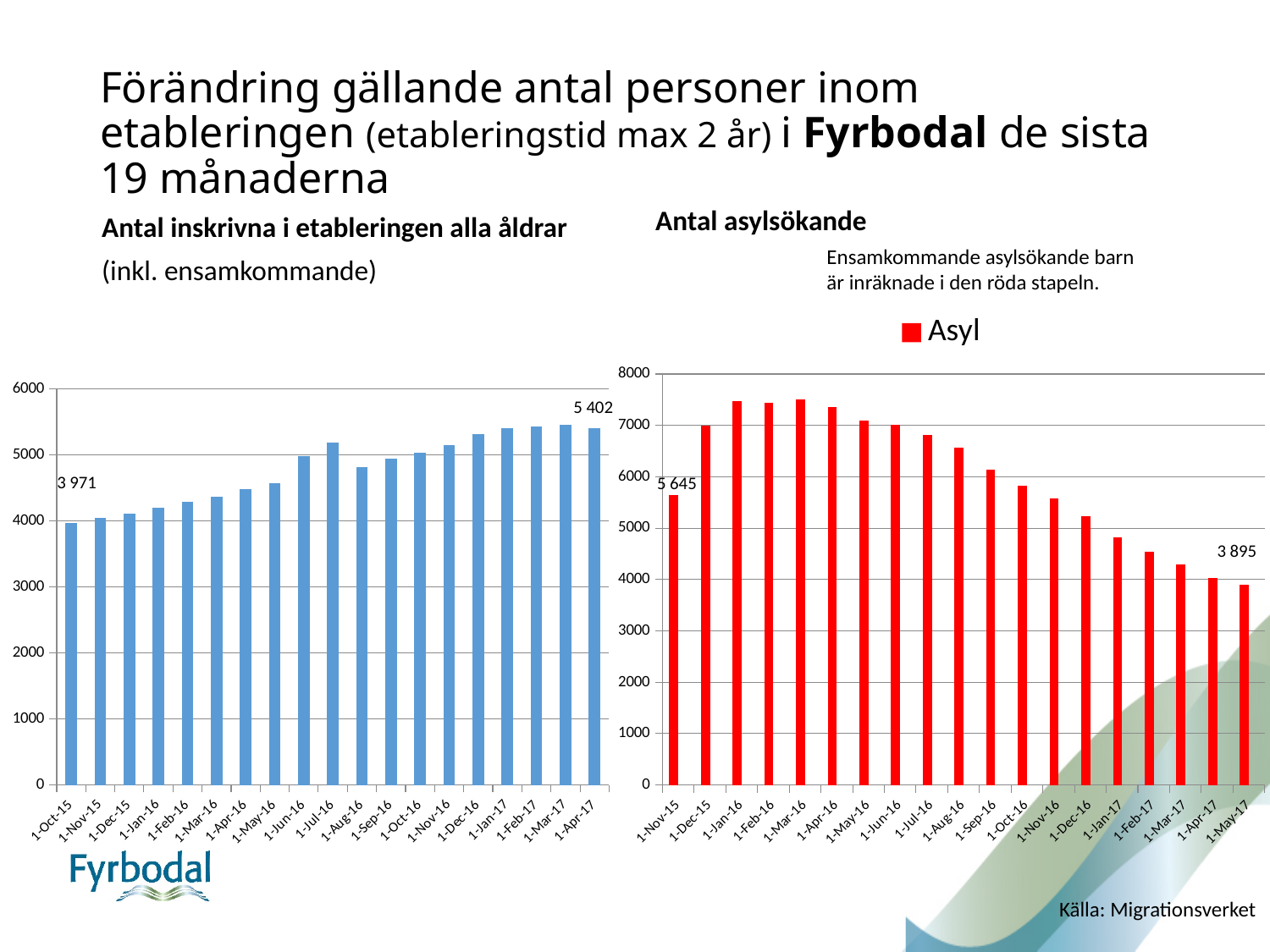
In the right chart (Antal asylsökande), what is the difference between the values for 1-Nov-15 and 1-May-17? 1 750 In the right chart (Antal asylsökande), which is larger, the value for 1-Mar-16 or the value for 1-Oct-16? 1-Mar-16 In the right chart (Antal asylsökande), what is the value for 1-May-17? 3 895 In the left chart (Antal inskrivna i etableringen alla åldrar), is the value for 1-Jul-16 greater or less than 5000? greater In the left chart (Antal inskrivna i etableringen alla åldrar), what is the value for 1-Oct-15? 3 971 What is the legend entry shown for the right chart (Antal asylsökande)? Asyl In the right chart (Antal asylsökande), which month has the lowest value? 1-May-17 In the left chart (Antal inskrivna i etableringen alla åldrar), do the values generally rise or fall from 1-Oct-15 to 1-Apr-17? rise How many bars are shown in the right chart (Antal asylsökande)? 19 In the left chart (Antal inskrivna i etableringen alla åldrar), what is the value for 1-Apr-17? 5 402 In the left chart (Antal inskrivna i etableringen alla åldrar), what is the difference between the values for 1-Apr-17 and 1-Oct-15? 1 431 In the right chart (Antal asylsökande), what is the value for 1-Nov-15? 5 645